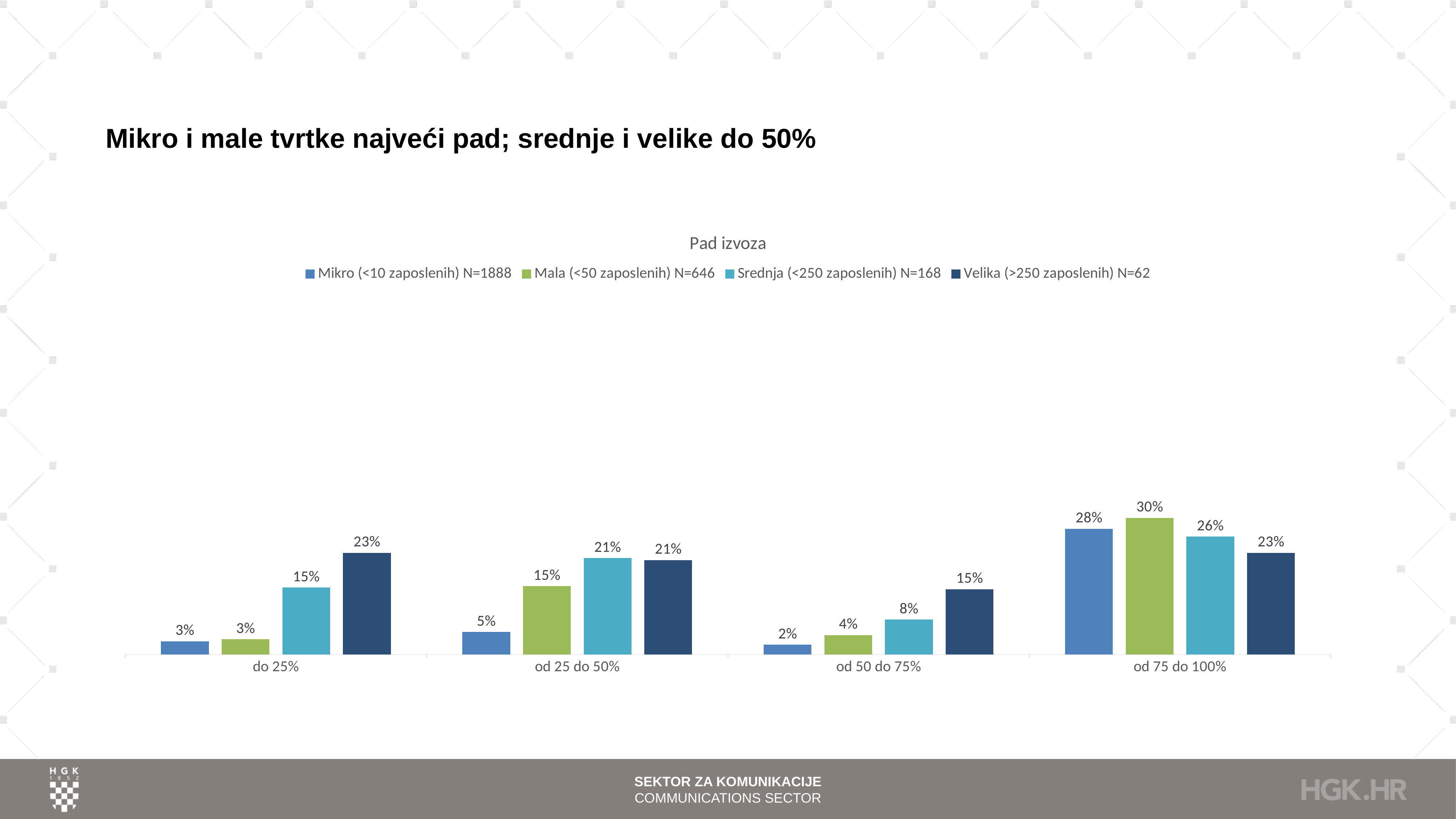
What is the difference between the Velika and Mikro values in the 'do 25%' category? 20% What kind of chart is shown on the slide? Bar chart Do the Mikro values rise or fall from 'od 50 do 75%' to 'od 75 do 100%'? Rise What is the value for Velika (>250 zaposlenih) in the 'do 25%' category? 23% What is the value for Mikro (<10 zaposlenih) in the 'od 75 do 100%' category? 28% How many categories are shown on the x axis? 4 Which is larger: the Srednja value in 'od 25 do 50%' or the Srednja value in 'od 75 do 100%'? od 75 do 100% What is the value for Srednja (<250 zaposlenih) in the 'od 50 do 75%' category? 8% Which series has the highest value in the 'od 75 do 100%' category? Mala (<50 zaposlenih) N=646 Which series has the lowest value in the 'od 50 do 75%' category? Mikro (<10 zaposlenih) N=1888 How many series does the legend list? 4 What is the title of the chart? Pad izvoza